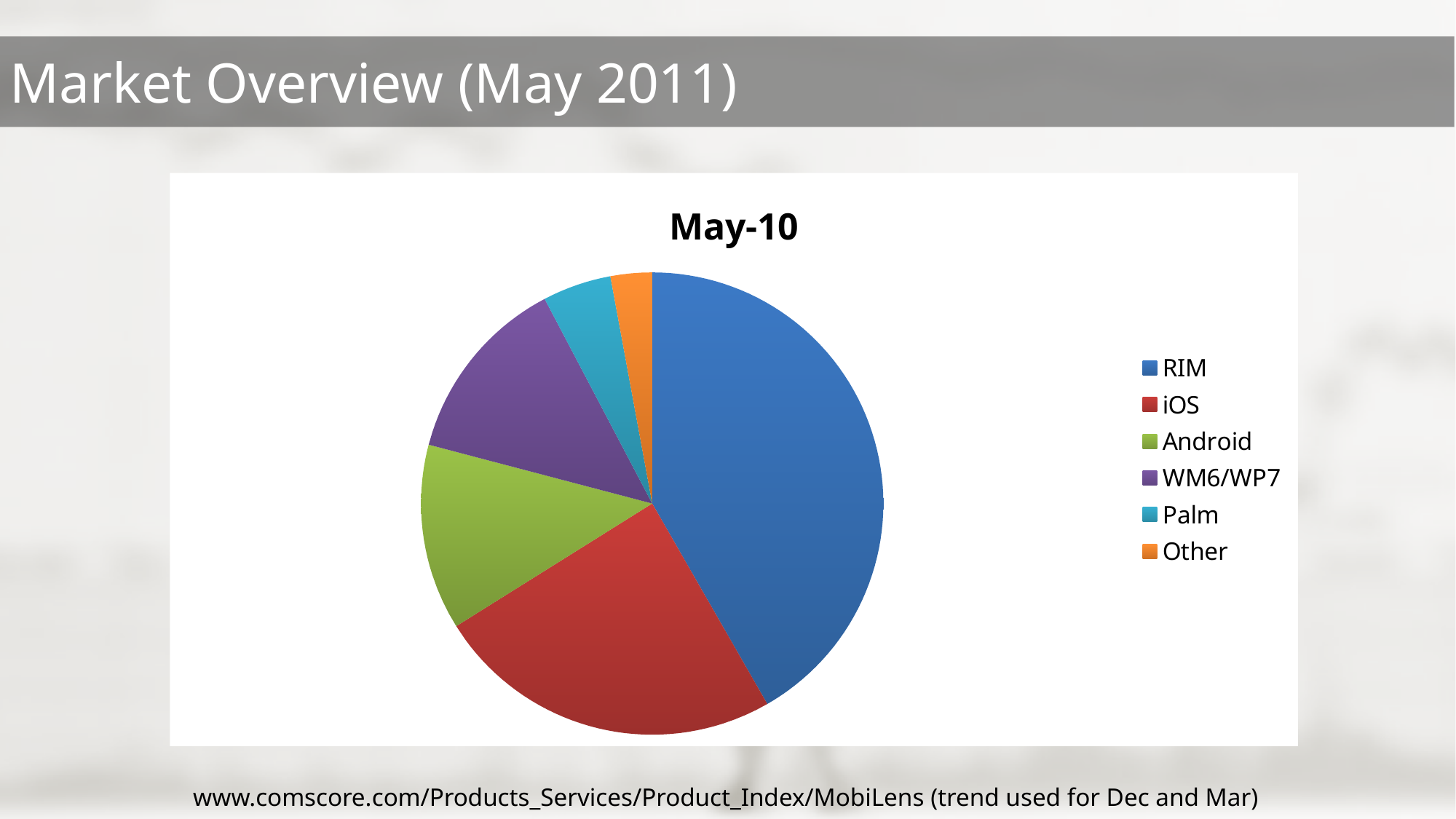
Which slice is larger, Android or Palm? Android Which slice is larger, iOS or Android? iOS Which category is listed second in the legend? iOS How many slices does the pie chart have? 6 Which slice is larger, Palm or Other? Palm Which category has the smallest slice of the pie? Other How many entries does the legend list? 6 What kind of chart is shown on the slide? Pie chart Which category has the largest slice of the pie? RIM What is the title of the chart? May-10 Which category is shown in blue in the pie chart? RIM